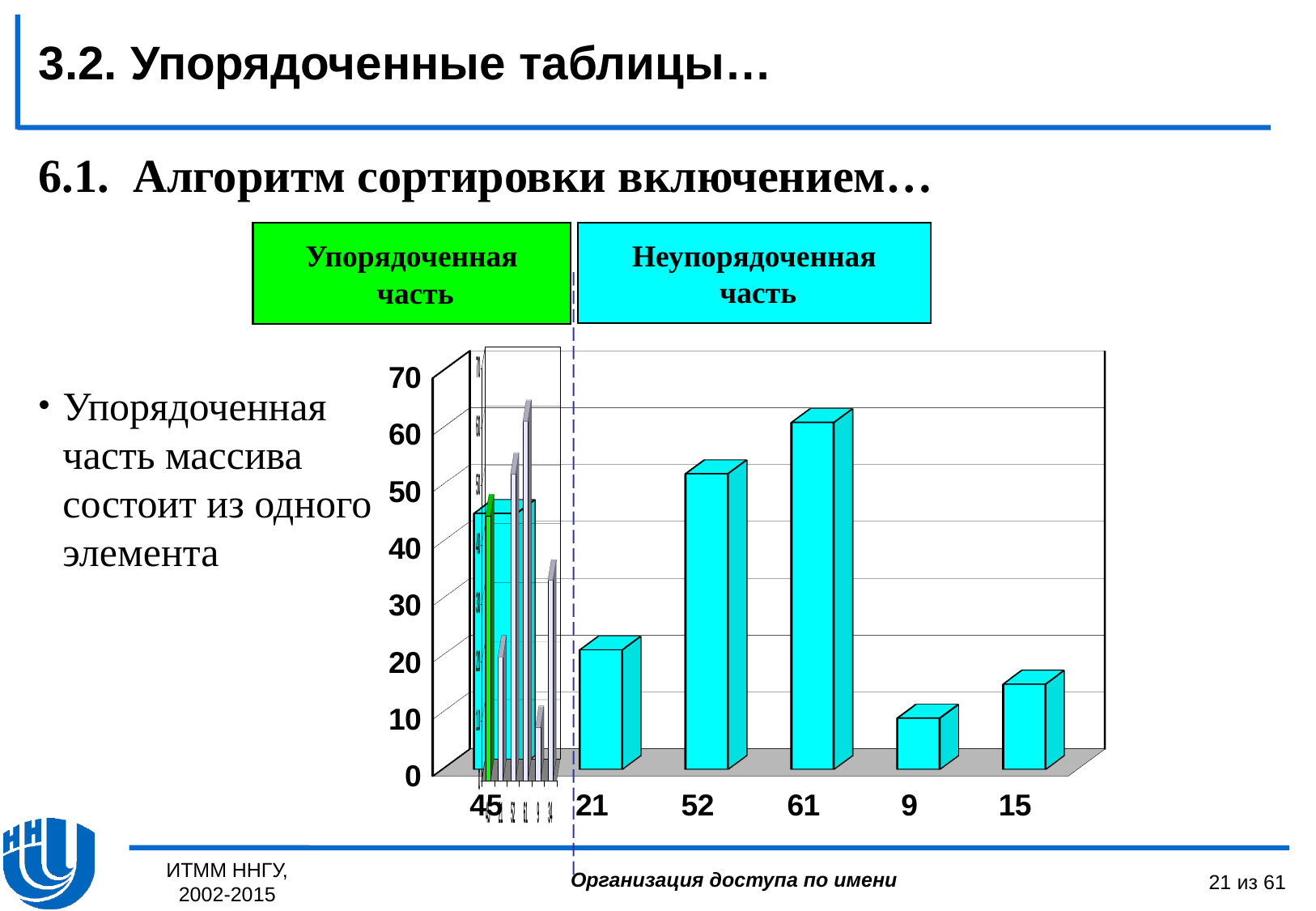
Among the bars in the unordered part of the chart, which bar is the shortest? 9 Is the height of the bar labelled 61 greater or less than 50? greater What kind of chart is shown on the slide? bar chart Among the bars in the unordered part of the chart, which bar is the tallest? 61 What label is written in the green box above the chart? Упорядоченная часть What is the highest value shown on the vertical axis of the chart? 70 Is the height of the bar labelled 15 greater or less than 20? less How many bars are in the unordered part (Неупорядоченная часть) of the chart, to the right of the dashed line? 5 Which bar is taller, the one labelled 15 or the one labelled 9? 15 Is the height of the bar labelled 52 greater or less than 40? greater Which bar is taller, the one labelled 52 or the one labelled 21? 52